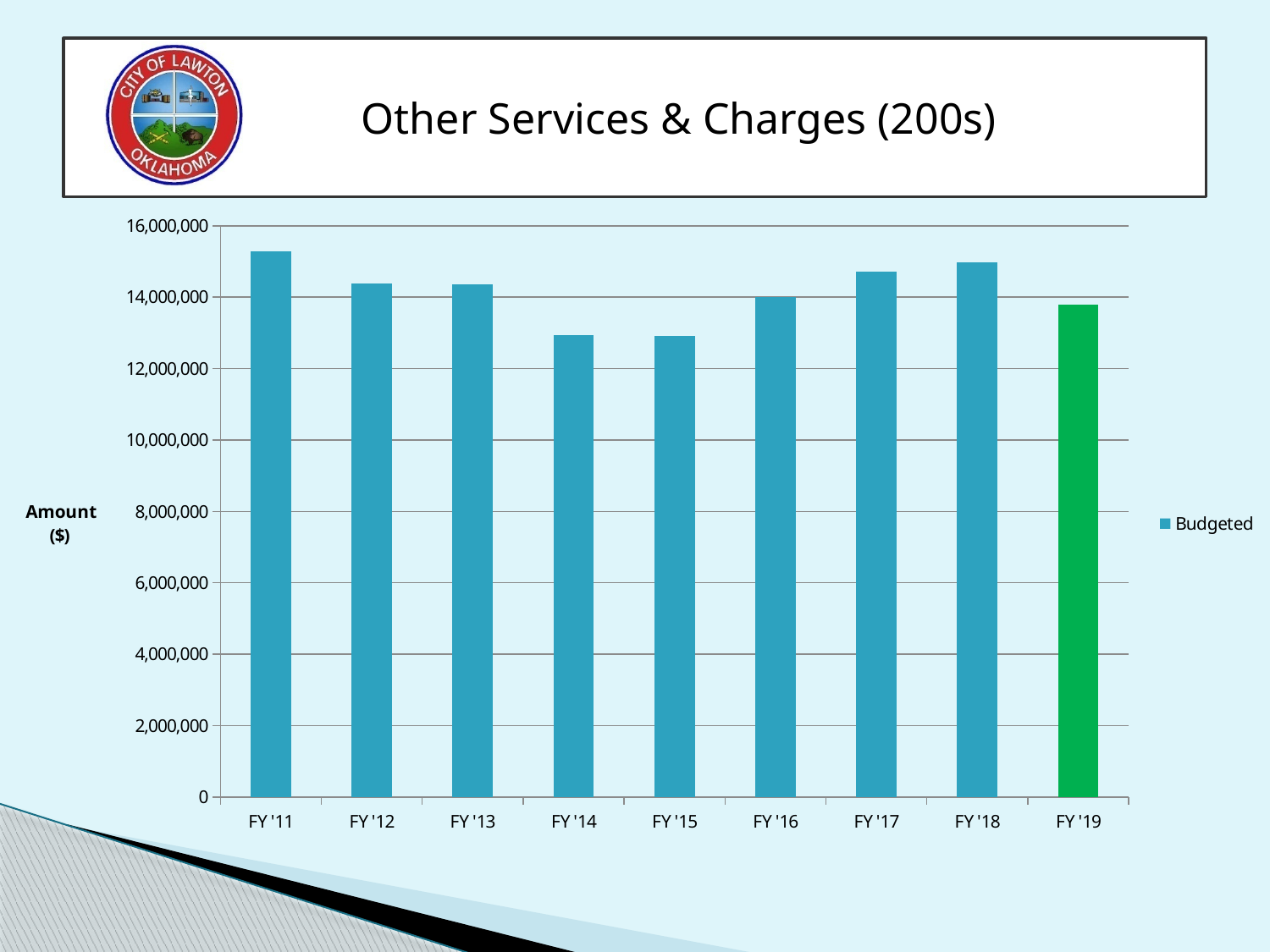
Which is larger, the value for FY '17 or the value for FY '14? FY '17 What is the name of the series shown in the legend? Budgeted How many fiscal years are plotted on the chart? 9 Which is larger, the value for FY '11 or the value for FY '19? FY '11 How many series does the legend list? 1 Is the value for FY '15 greater or less than 12,000,000? greater Is the value for FY '19 greater or less than 14,000,000? less What kind of chart is shown on the slide? Bar chart Is the value for FY '14 greater or less than 14,000,000? less Which fiscal year has the highest budgeted amount? FY '11 What is the label on the vertical axis of the chart? Amount ($)